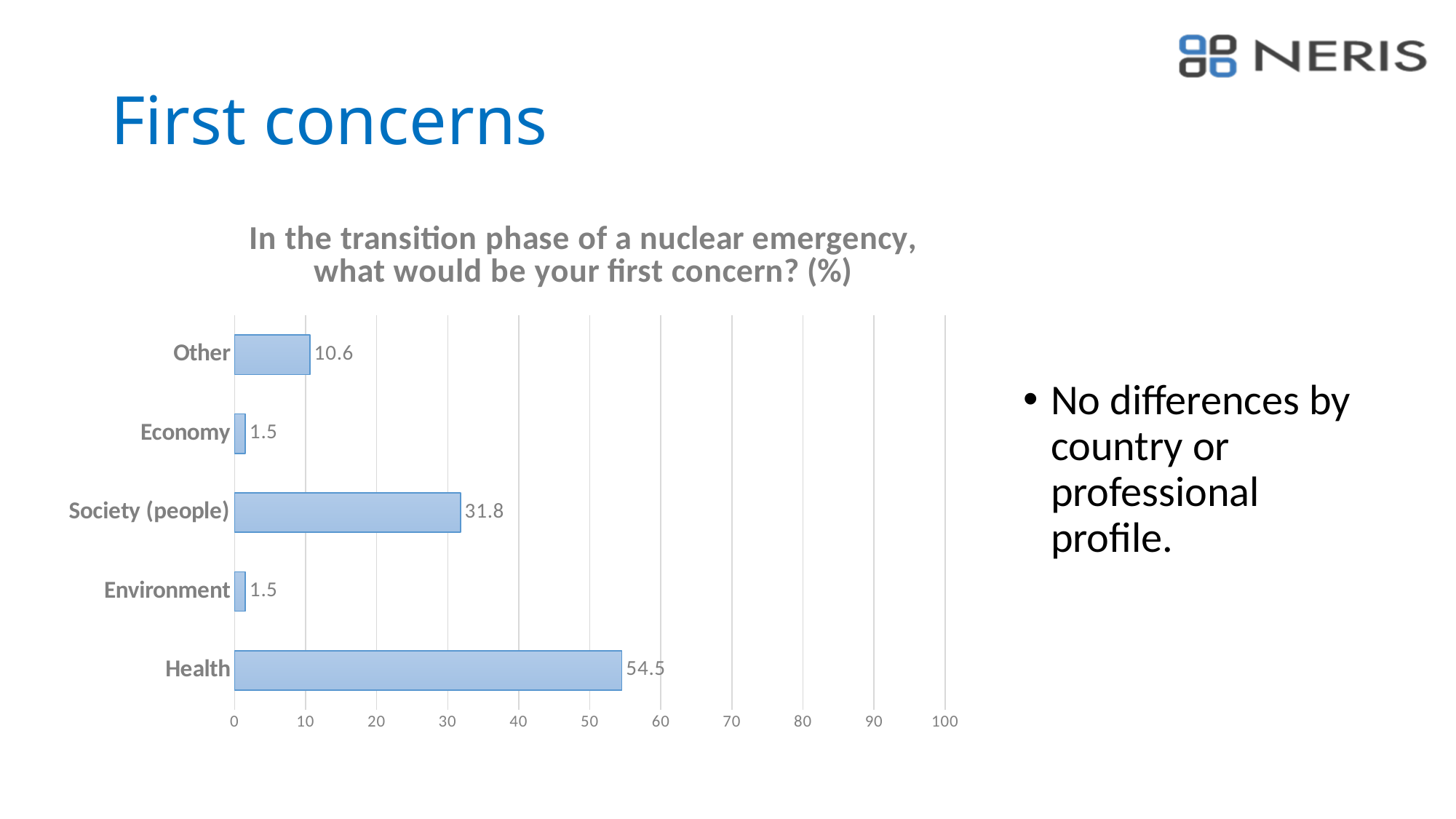
Which is larger, the value for Other or the value for Environment? Other What is the difference between the values for Society (people) and Other? 21.2 How many categories are shown in the chart? 5 What is the difference between the values for Health and Society (people)? 22.7 Which category has the highest value? Health What is the value for Economy? 1.5 What is the value for Other? 10.6 What is the value for Health? 54.5 What is the title of the chart? In the transition phase of a nuclear emergency, what would be your first concern? (%) What is the value for Society (people)? 31.8 Is the value for Health greater or less than 50? greater What kind of chart is shown on the slide? Bar chart